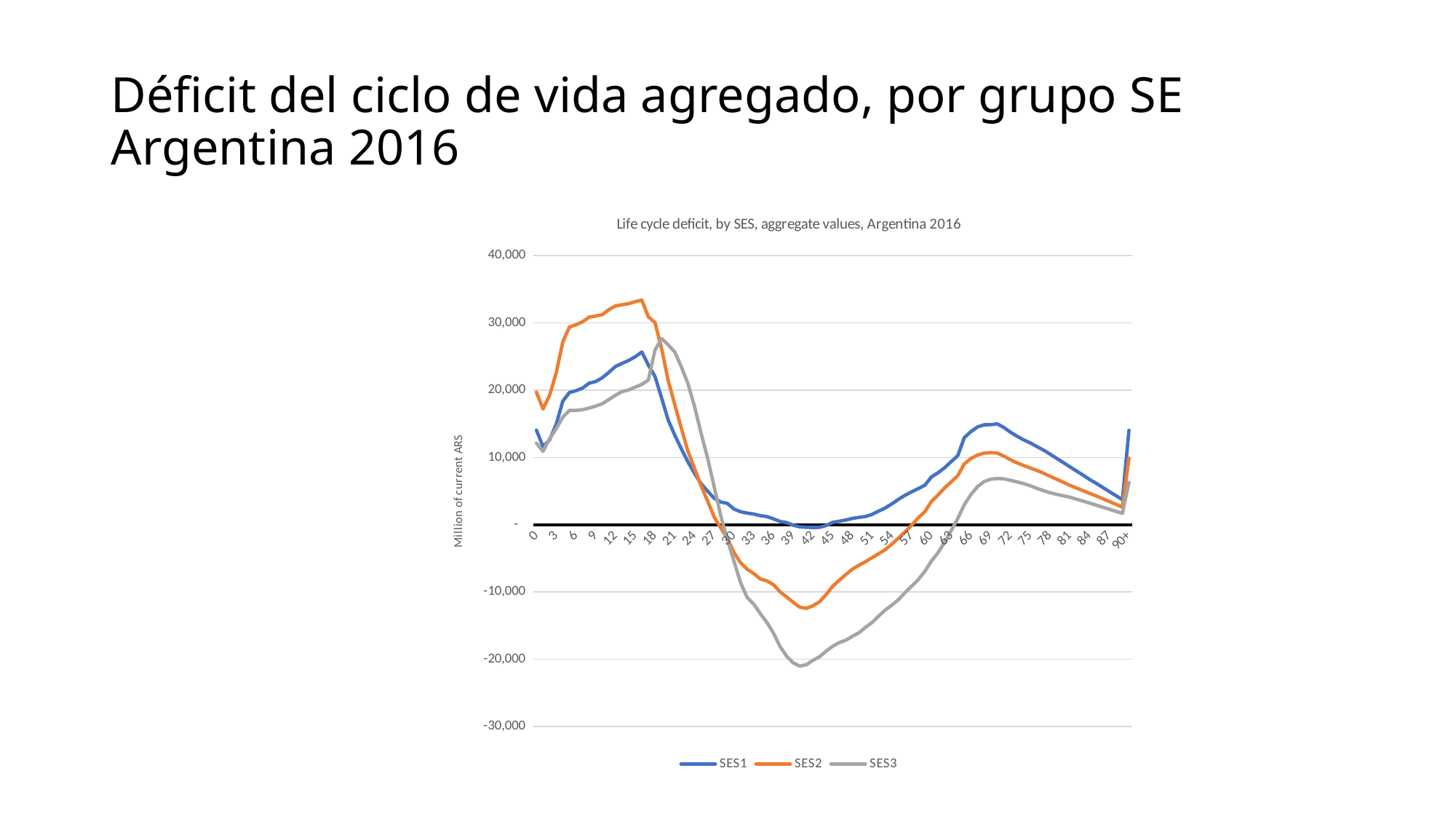
What is the label on the vertical axis of the chart? Million of current ARS Is the value for SES2 at age 15 greater or less than 30,000? greater How many series does the legend list? 3 At age 15, which series has the larger value, SES1 or SES2? SES2 Does the SES2 line rise or fall between age 18 and age 39? fall At age 39, which series has the larger value, SES1 or SES3? SES1 Is the value for SES3 at age 39 greater or less than -10,000? less What kind of chart is shown on the slide? line chart Which series reaches the lowest value on the chart? SES3 Which series reaches the highest peak value on the chart? SES2 What is the title of the chart? Life cycle deficit, by SES, aggregate values, Argentina 2016 Is the value for SES1 at age 69 greater or less than 10,000? greater